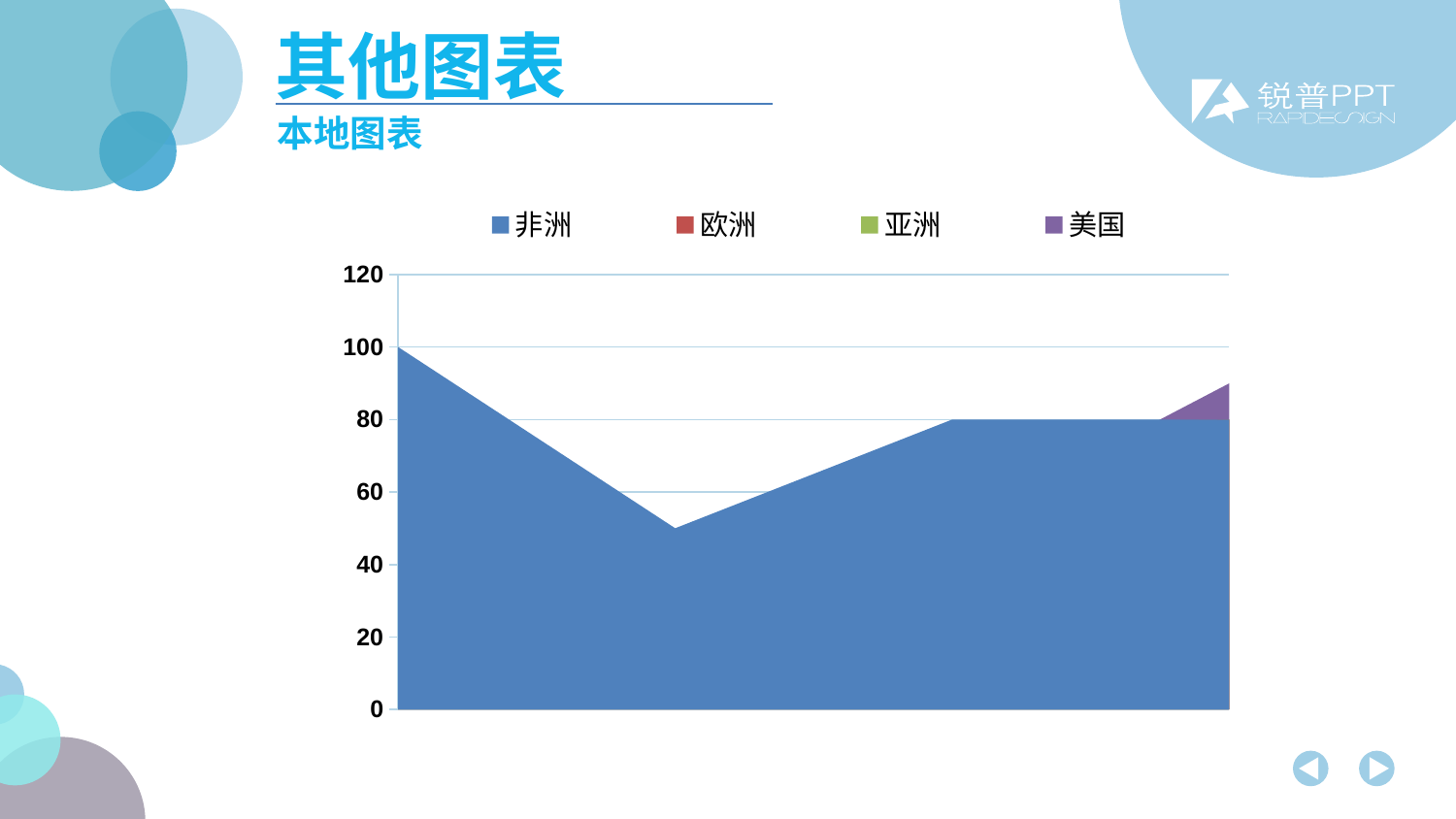
Is the lowest value of the 非洲 series greater or less than 60? less What are the series names listed in the legend? 非洲, 欧洲, 亚洲, 美国 How many series does the legend list? 4 What colour is the 非洲 series drawn in? blue What kind of chart is shown on the slide? area chart Is the top of the 美国 area at the rightmost point greater or less than 100? less Is the lowest value of the 非洲 series greater or less than 40? greater What is the difference between the leftmost and rightmost values of the 非洲 series? 20 Which series covers the largest area of the chart? 非洲 Which is larger for the 非洲 series: the leftmost value or the rightmost value? the leftmost value What is the value of the 非洲 series at the rightmost point of the chart? 80 What is the value of the 非洲 series at the leftmost point of the chart? 100